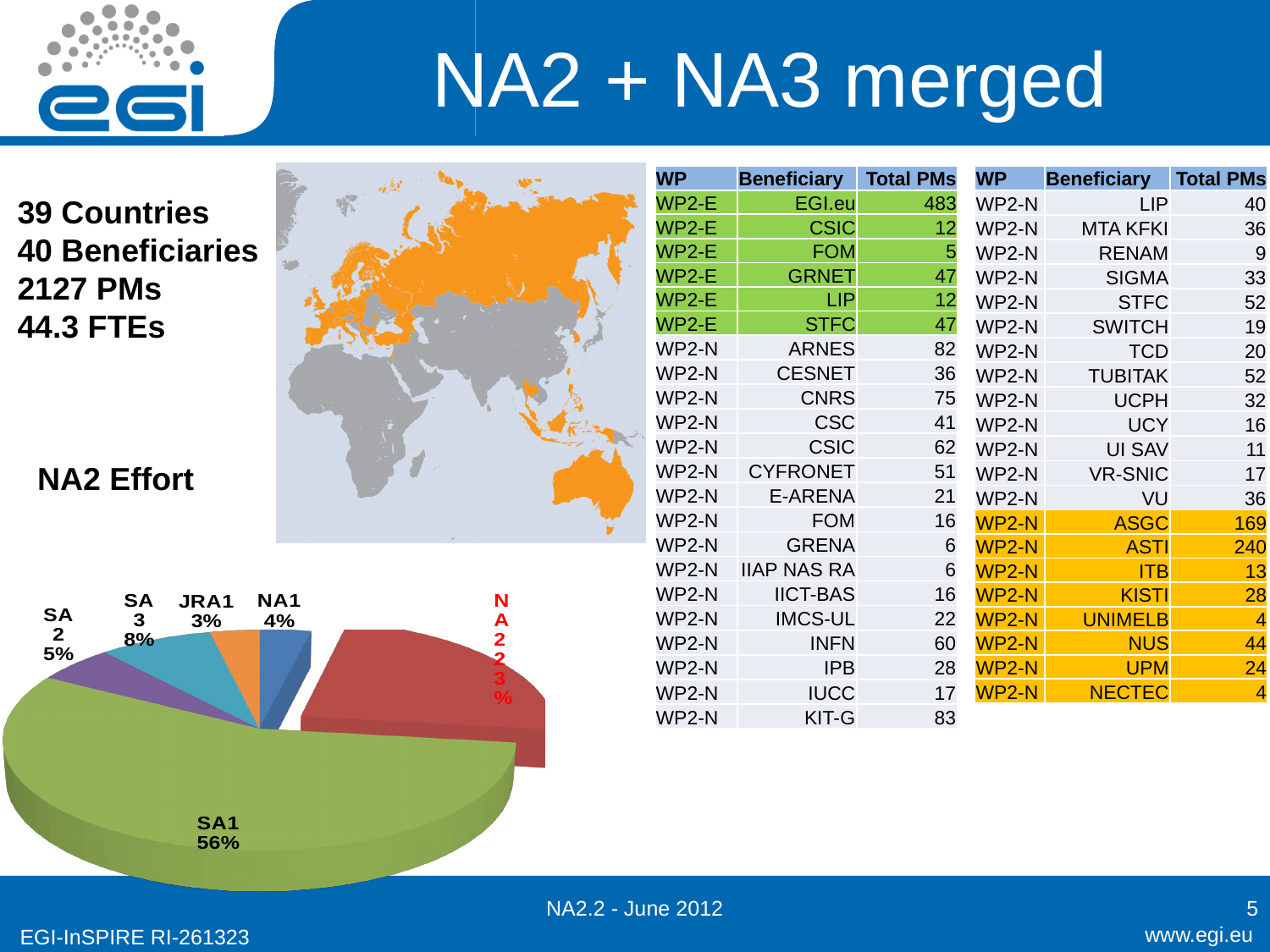
What kind of chart is shown at the bottom left of the slide? pie chart In the pie chart, what share does SA3 have? 8% How many slices does the pie chart have? 6 In the pie chart, what share does NA1 have? 4% In the pie chart, what share does SA2 have? 5% In the pie chart, what is the difference between the SA1 share and the NA2 share? 33% In the pie chart, what share does NA2 have? 23% In the pie chart, which is larger, the share for SA3 or the share for SA2? SA3 Which slice of the pie chart is the largest? SA1 In the pie chart, what share does JRA1 have? 3% In the pie chart, what share does SA1 have? 56% Which slice of the pie chart is the smallest? JRA1